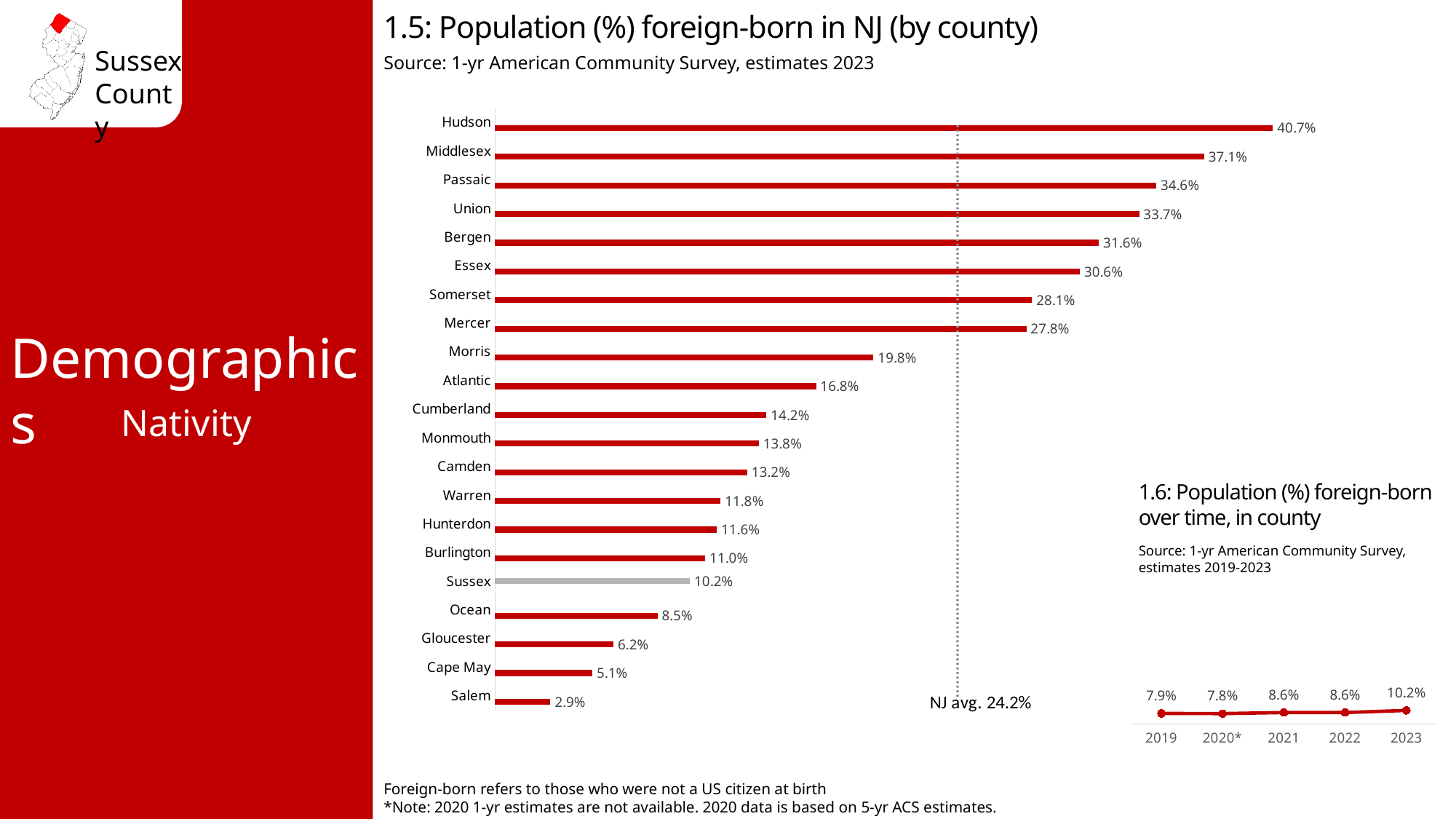
In chart 1.5 (Population (%) foreign-born in NJ by county), what NJ average is marked by the dotted line? 24.2% In chart 1.6 (Population (%) foreign-born over time, in county), how many data points are plotted? 5 In chart 1.5 (Population (%) foreign-born in NJ by county), which county has the lowest value? Salem In chart 1.5 (Population (%) foreign-born in NJ by county), what is the value for Sussex? 10.2% In chart 1.6 (Population (%) foreign-born over time, in county), what is the value for 2021? 8.6% In chart 1.5 (Population (%) foreign-born in NJ by county), which is larger, Warren or Hunterdon? Warren In chart 1.5 (Population (%) foreign-born in NJ by county), how many counties are shown? 21 In chart 1.6 (Population (%) foreign-born over time, in county), what is the difference between the 2023 and 2019 values? 2.3% In chart 1.5 (Population (%) foreign-born in NJ by county), what is the value for Bergen? 31.6% In chart 1.5 (Population (%) foreign-born in NJ by county), which county has the highest value? Hudson In chart 1.5 (Population (%) foreign-born in NJ by county), what is the difference between Hudson and Sussex? 30.5% What kind of chart is chart 1.5 (Population (%) foreign-born in NJ by county)? bar chart